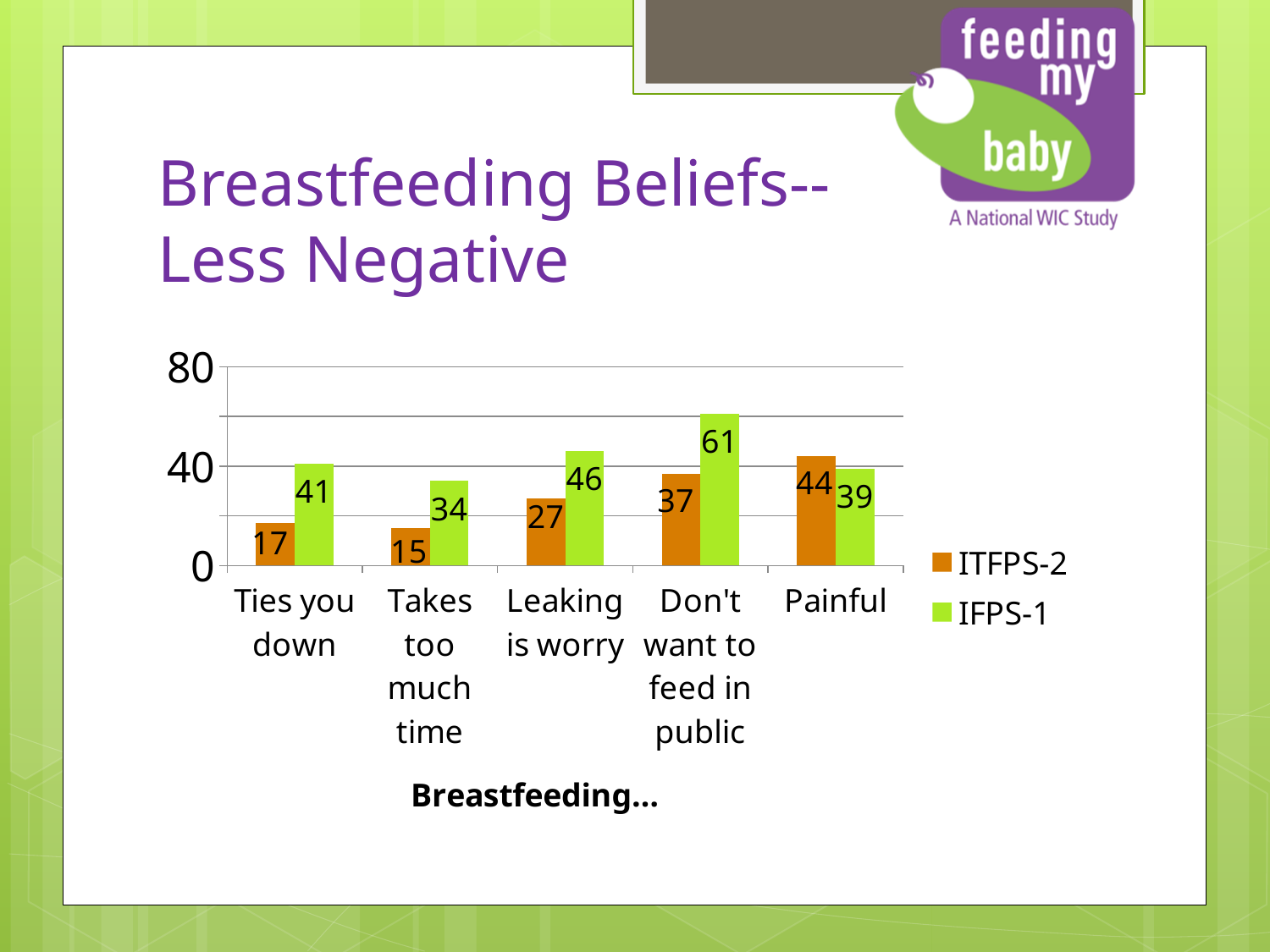
Which category has the lowest ITFPS-2 value? Takes too much time What is the x-axis title of the chart? Breastfeeding... Is the IFPS-1 value for "Takes too much time" greater or less than 40? less What is the ITFPS-2 value for "Leaking is worry"? 27 For "Painful", which series has the larger value, ITFPS-2 or IFPS-1? ITFPS-2 What is the IFPS-1 value for "Don't want to feed in public"? 61 What kind of chart is shown on the slide? bar chart How many series does the legend list? 2 What is the ITFPS-2 value for "Ties you down"? 17 How many categories are shown on the x axis? 5 What is the difference between the IFPS-1 and ITFPS-2 values for "Ties you down"? 24 Which category has the highest IFPS-1 value? Don't want to feed in public